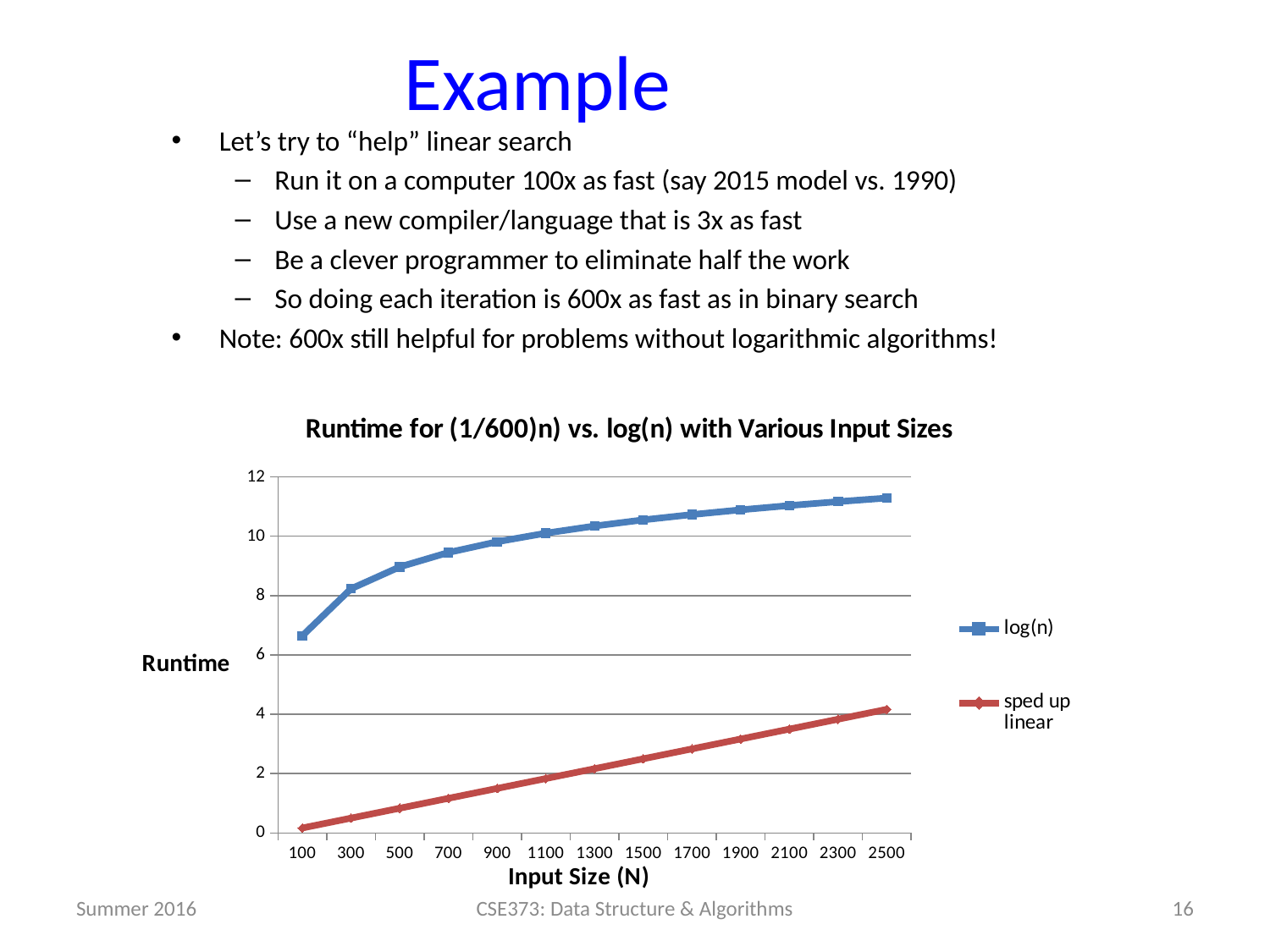
Is the log(n) runtime at input size 100 greater or less than 8? less Does the sped up linear series rise or fall as input size increases? rise What kind of chart is shown on the slide? line chart How many series does the legend list? 2 At which input size is the sped up linear runtime highest? 2500 Does the log(n) series rise or fall as input size increases? rise Is the sped up linear runtime at input size 2500 greater or less than 6? less Is the log(n) runtime at input size 2500 greater or less than 10? greater At input size 2500, which series has the larger runtime, log(n) or sped up linear? log(n) At which input size is the log(n) runtime lowest? 100 How many input size values are marked along the x axis? 13 What is the title of the chart? Runtime for (1/600)n) vs. log(n) with Various Input Sizes